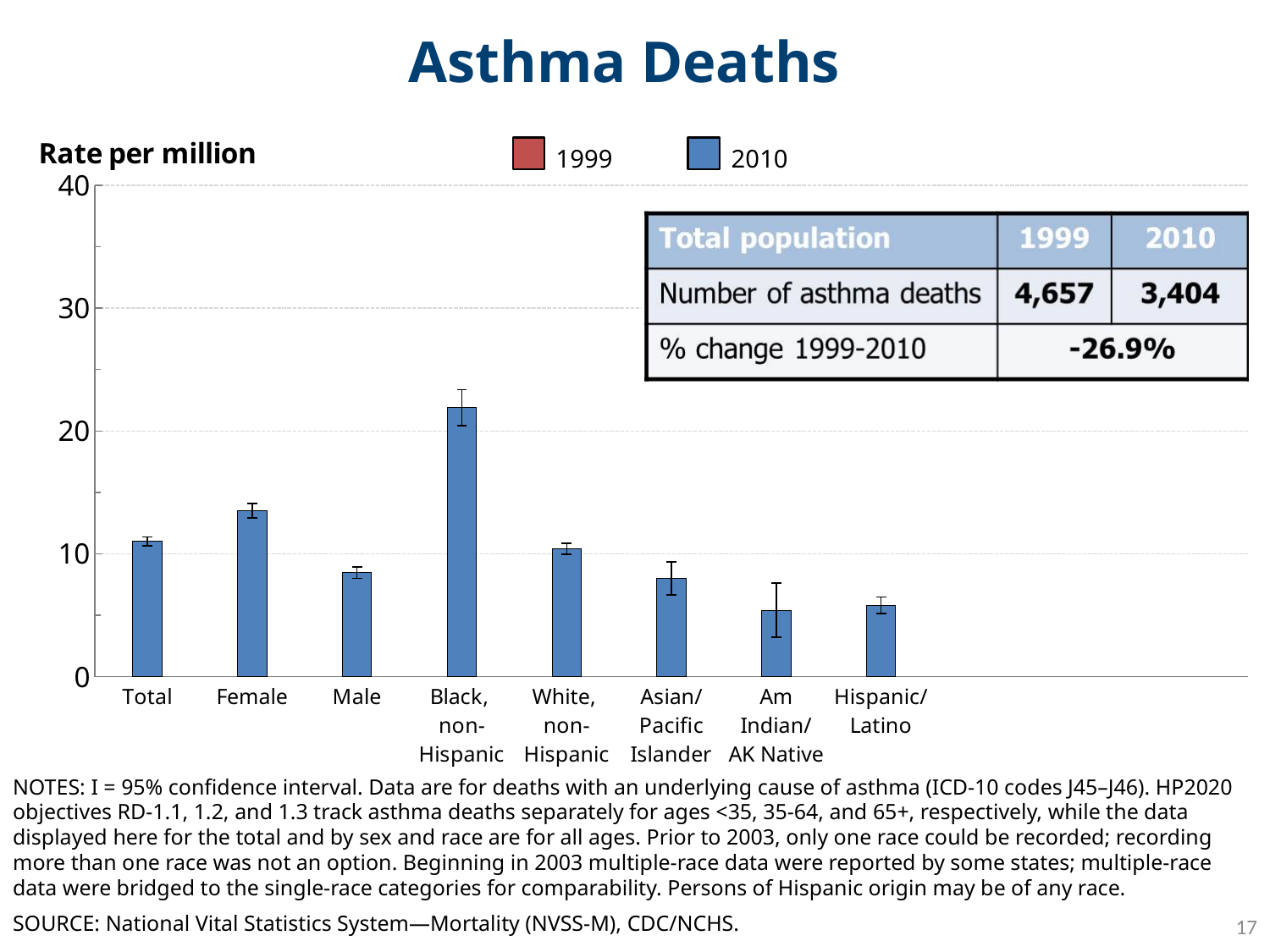
What kind of chart is shown on the slide? bar chart How many categories are shown along the x axis of the chart? 8 Which is larger, the value for Female or the value for Male? Female Is the value for Black, non-Hispanic greater or less than 20? greater Is the value for Am Indian/AK Native greater or less than 10? less Which is larger, the value for Black, non-Hispanic or the value for White, non-Hispanic? Black, non-Hispanic What is the label on the y axis of the chart? Rate per million Is the value for Hispanic/Latino greater or less than 10? less Which category has the highest asthma death rate in the chart? Black, non-Hispanic How many series does the chart's legend list? 2